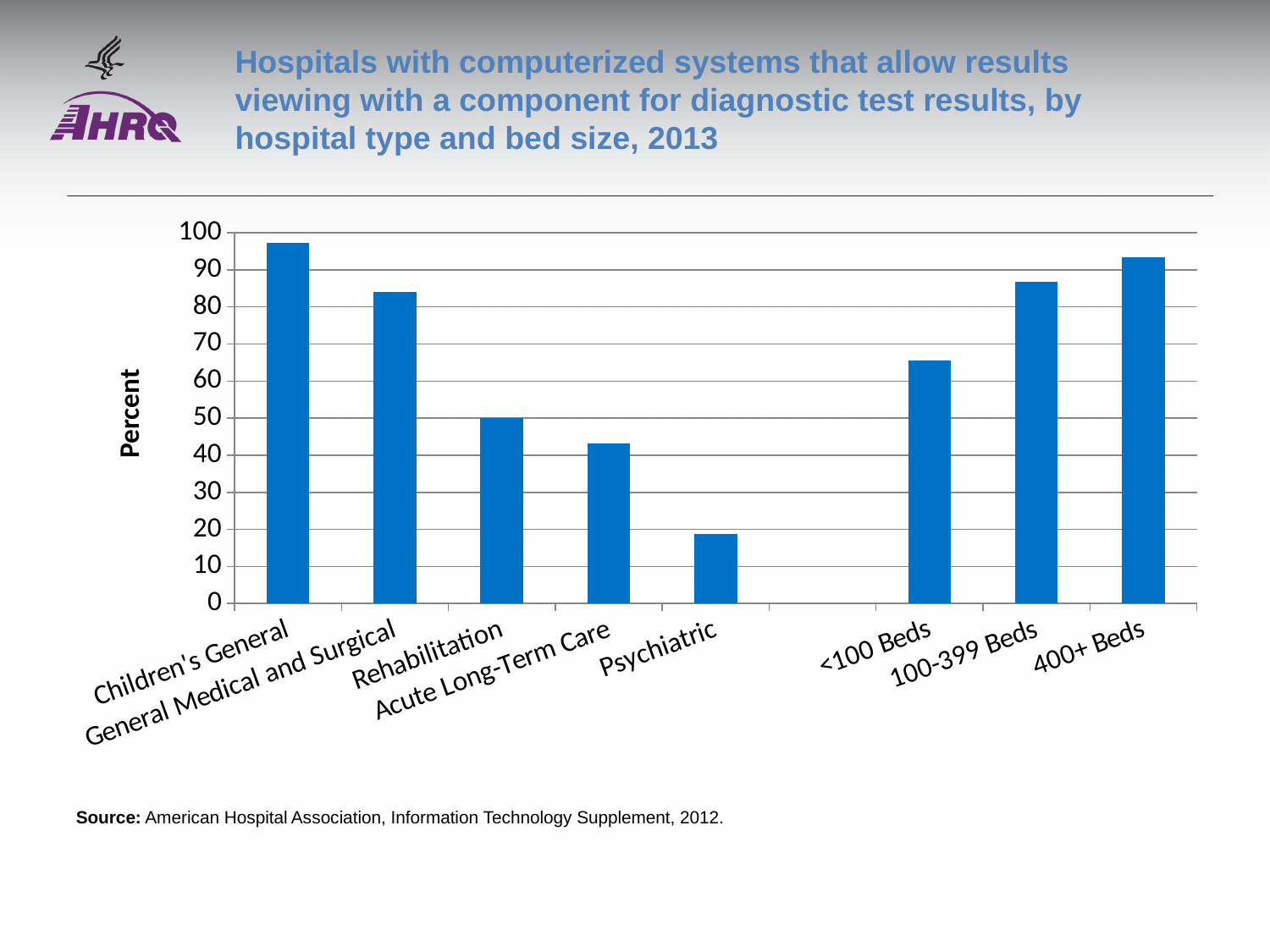
Do the values rise or fall across the bed-size categories from <100 Beds to 400+ Beds? rise Which is larger, the value for 400+ Beds or the value for <100 Beds? 400+ Beds Is the value for <100 Beds greater or less than 60? greater How many categories are plotted on the chart? 8 Is the value for Acute Long-Term Care greater or less than 50? less Which category has the lowest value? Psychiatric What is the label on the vertical axis? Percent Is the value for Psychiatric greater or less than 20? less Which category has the highest value? Children's General Which is larger, the value for General Medical and Surgical or the value for Rehabilitation? General Medical and Surgical What kind of chart is shown on the slide? bar chart